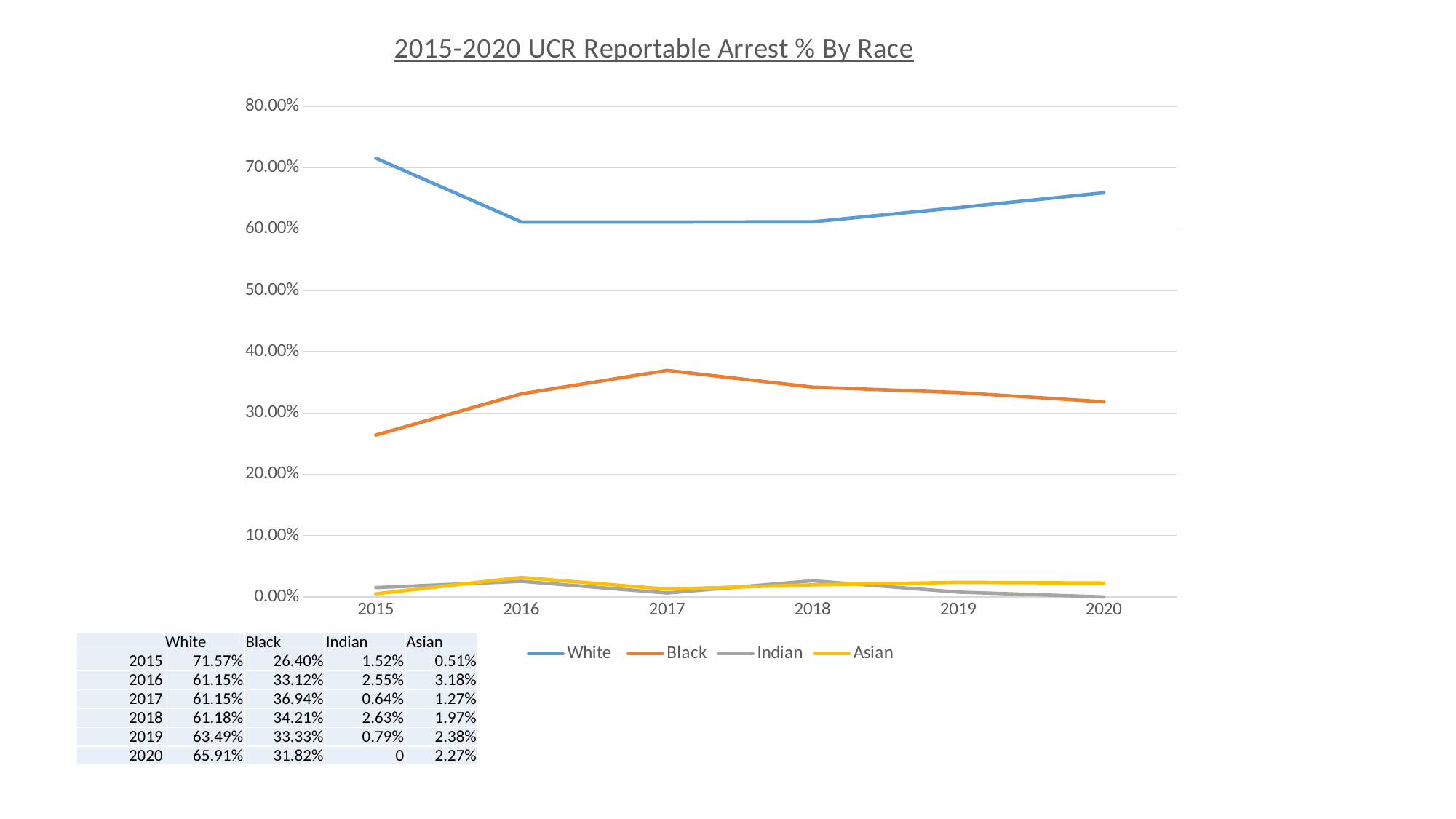
What is the Black arrest percentage in 2017? 36.94% Is the White value for 2015 greater or less than 70.00%? greater What is the Asian arrest percentage in 2016? 3.18% In which year is the Black series at its highest? 2017 Does the Black series rise or fall from 2015 to 2017? rise What is the White arrest percentage in 2015? 71.57% How many series does the legend list? 4 What is the difference between the White and Black percentages in 2020? 34.09% How many years are plotted along the x axis? 6 Which is larger in 2018, the Indian value or the Asian value? Indian What type of chart is shown on the slide? line chart In which year is the White series at its lowest? 2016 and 2017 (tied at 61.15%)